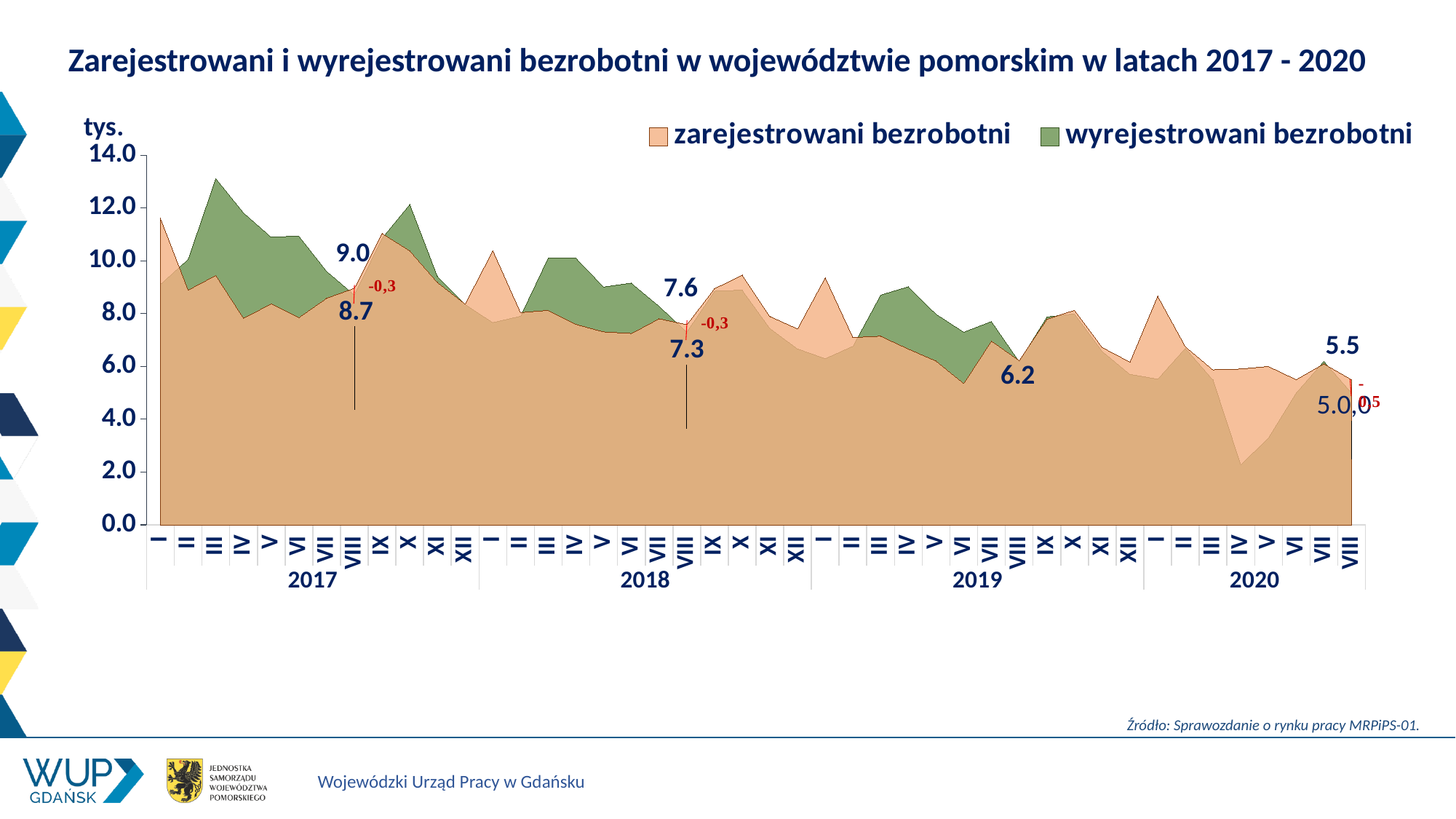
What is the labelled value for wyrejestrowani bezrobotni in VIII 2017? 8.7 What is the labelled value for zarejestrowani bezrobotni in VIII 2017? 9.0 What kind of chart is shown on the slide? area chart How many series does the legend list? 2 What is the labelled value for zarejestrowani bezrobotni in VIII 2020? 5.5 What unit is shown at the top of the vertical axis? tys. What is the labelled value for wyrejestrowani bezrobotni in VIII 2020? 5.0 Do the labelled August (VIII) values for wyrejestrowani bezrobotni rise or fall from 2017 to 2020? fall What difference is annotated in red between the two series in VIII 2020? -0,5 What is the labelled value for wyrejestrowani bezrobotni in VIII 2018? 7.3 What are the two series named in the legend? zarejestrowani bezrobotni; wyrejestrowani bezrobotni In VIII 2018, which series has the larger labelled value, zarejestrowani bezrobotni or wyrejestrowani bezrobotni? zarejestrowani bezrobotni